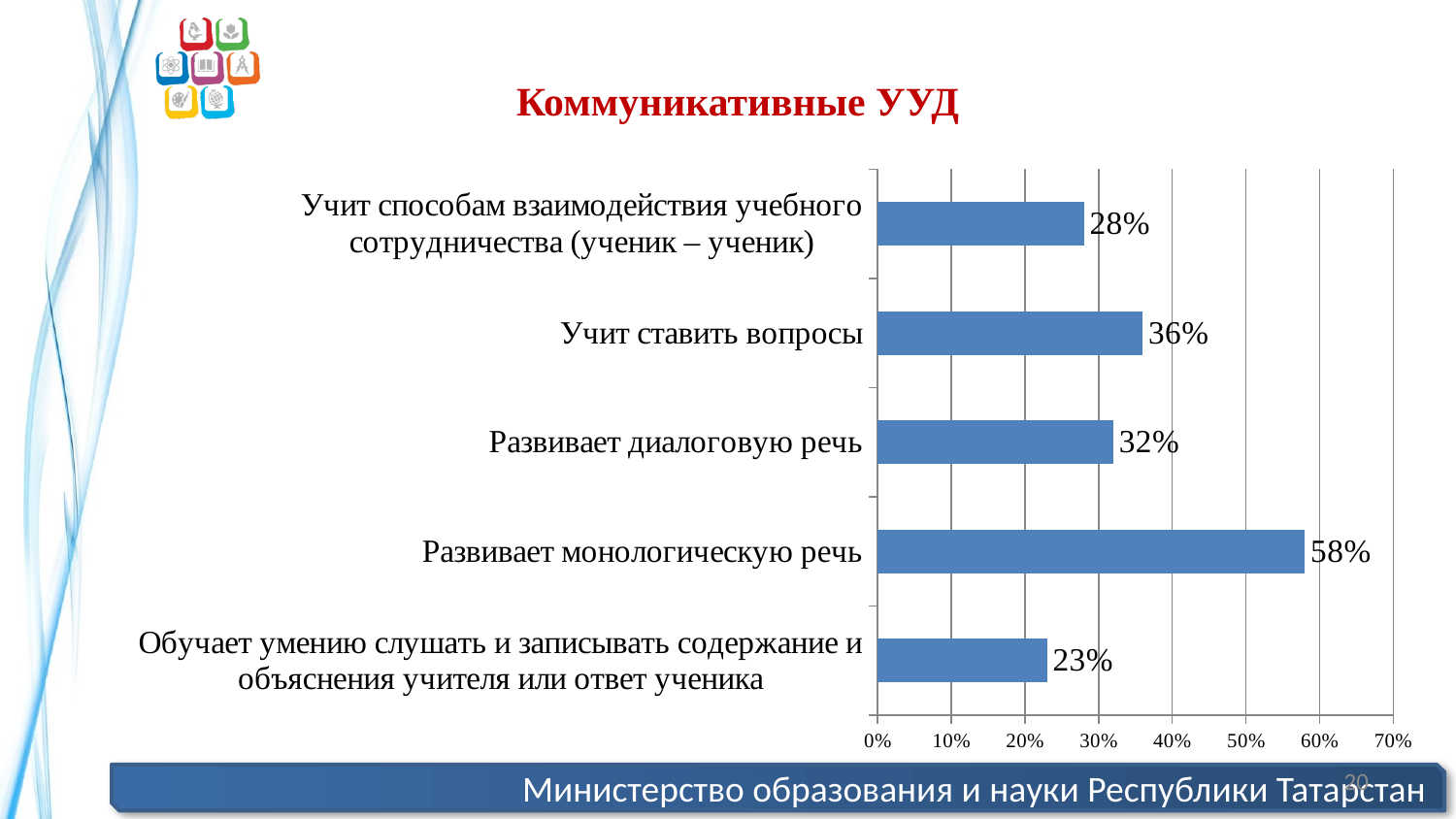
Which category has the lowest value? Обучает умению слушать и записывать содержание и объяснения учителя или ответ ученика What is the maximum value shown on the horizontal axis? 70% What is the value for "Обучает умению слушать и записывать содержание и объяснения учителя или ответ ученика"? 23% Which is larger: the value for "Учит ставить вопросы" or the value for "Учит способам взаимодействия учебного сотрудничества (ученик – ученик)"? Учит ставить вопросы Which category has the highest value? Развивает монологическую речь What is the title of the chart? Коммуникативные УУД What is the difference between the values for "Развивает монологическую речь" and "Развивает диалоговую речь"? 26% What kind of chart is shown on the slide? bar chart What is the value for "Развивает монологическую речь"? 58% What is the value for "Учит ставить вопросы"? 36% Is the value for "Развивает диалоговую речь" greater or less than 30%? greater How many categories are shown in the chart? 5